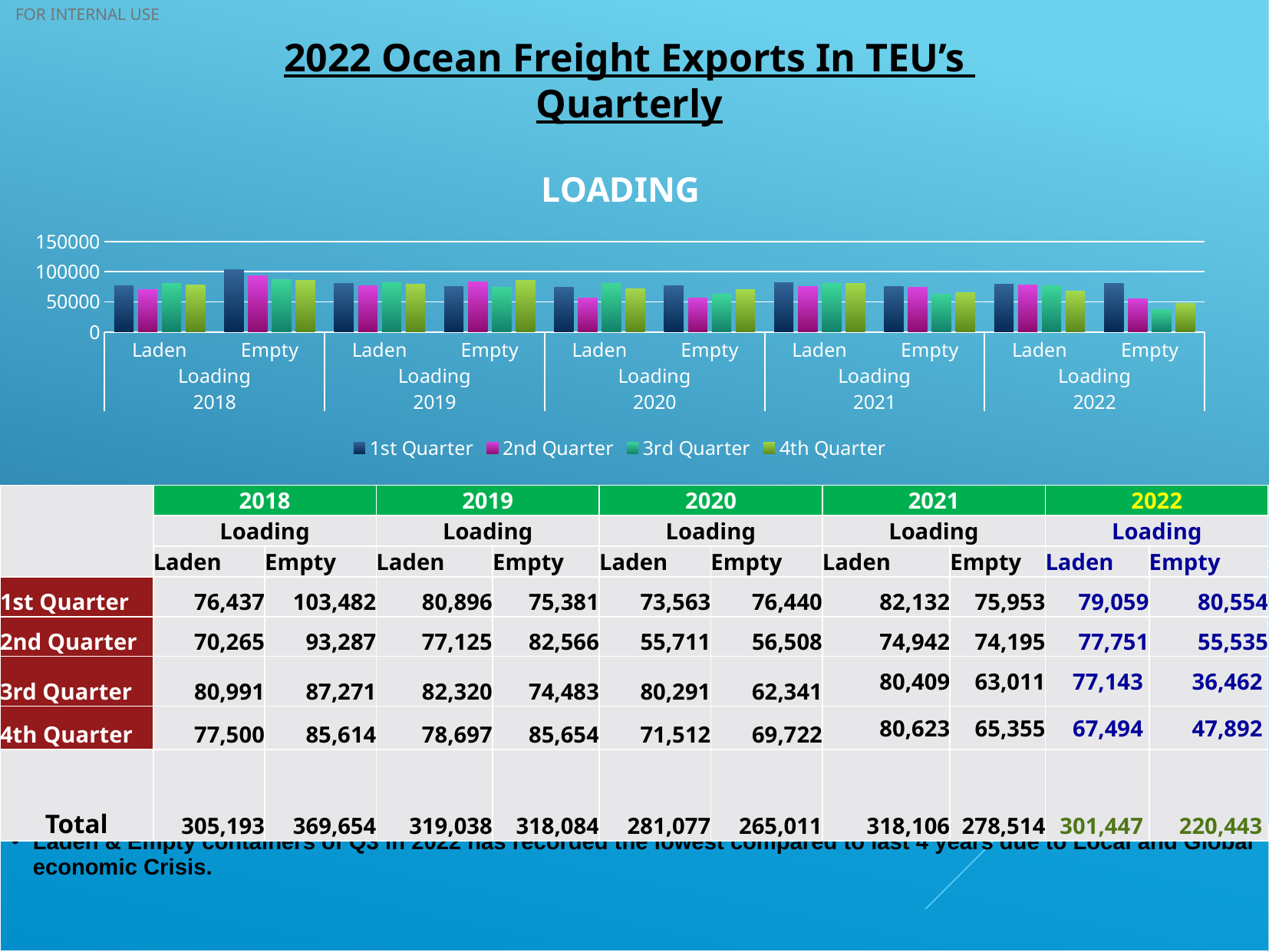
What is the 1st Quarter value for Empty loading in 2018? 103,482 How many Laden/Empty category groups are plotted along the x axis of the LOADING chart? 10 Is the 3rd Quarter value for Empty loading in 2022 greater or less than 50000? less What is the difference between the 1st Quarter and 2nd Quarter values for Empty loading in 2018? 10,195 What is the 2nd Quarter value for Laden loading in 2020? 55,711 How many series does the legend of the LOADING chart list? 4 What kind of chart is shown on the slide? bar chart Which bar is the highest in the LOADING chart? 1st Quarter, Empty 2018 Which is larger: the 1st Quarter Laden value in 2022 or the 2nd Quarter Empty value in 2022? 1st Quarter Laden 2022 Which bar is the lowest in the LOADING chart? 3rd Quarter, Empty 2022 Do the Laden loading values for 2022 rise or fall from the 1st Quarter to the 4th Quarter? fall Is the 1st Quarter value for Empty loading in 2018 greater or less than 100000? greater